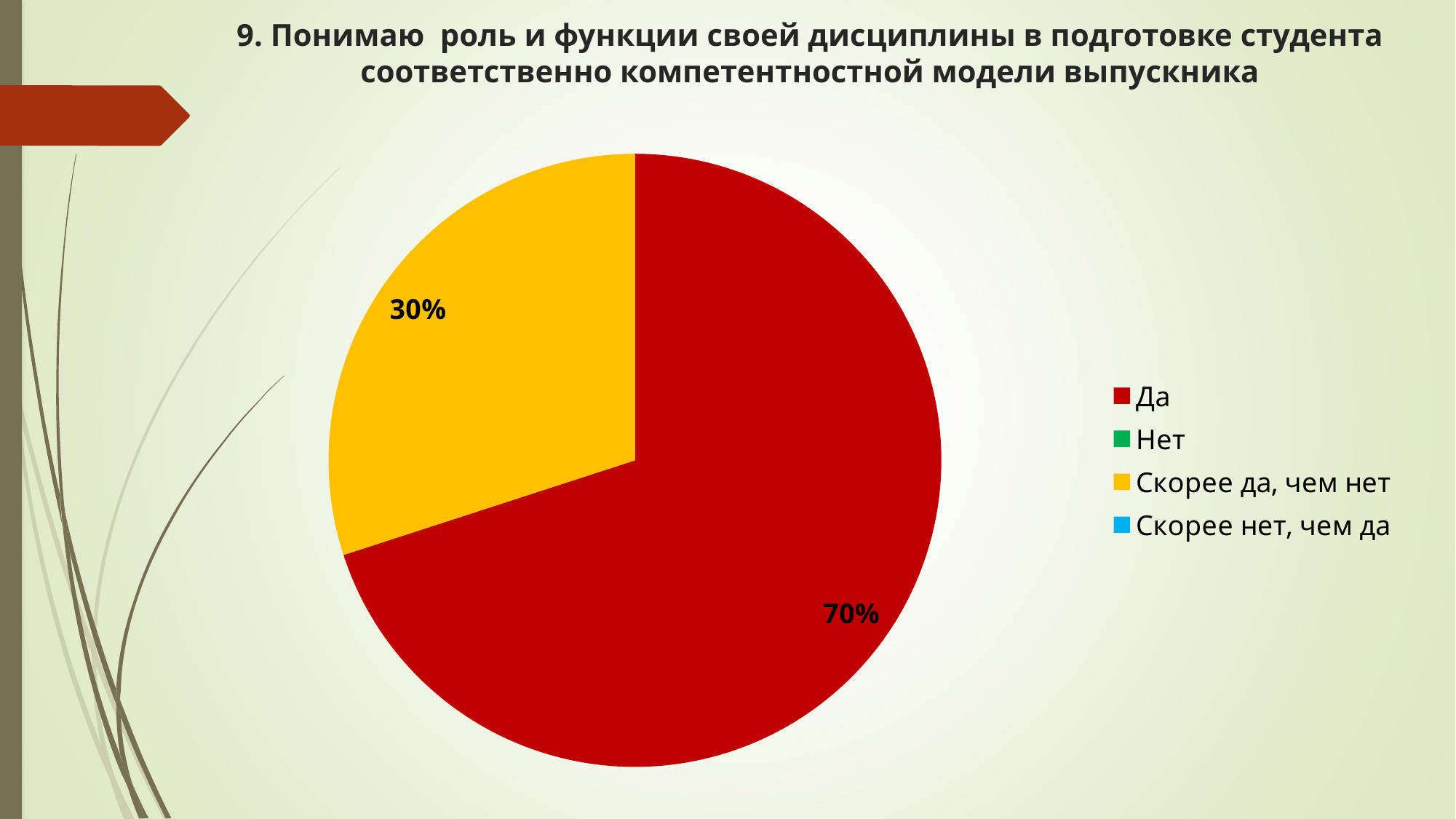
What share of the pie does the "Скорее да, чем нет" slice represent? 30% Which legend entry is shown with a red marker? Да What colour is the "Скорее да, чем нет" slice? yellow How many slices with data labels are visible in the pie? 2 What is the difference in percentage points between the "Да" slice and the "Скорее да, чем нет" slice? 40% How many entries does the legend list? 4 What share of the pie does the "Да" slice represent? 70% Which category has the largest slice of the pie? Да Which of the two labelled slices is larger, "Да" or "Скорее да, чем нет"? Да What kind of chart is shown on the slide? pie chart Is the share for "Да" greater or less than 50%? greater